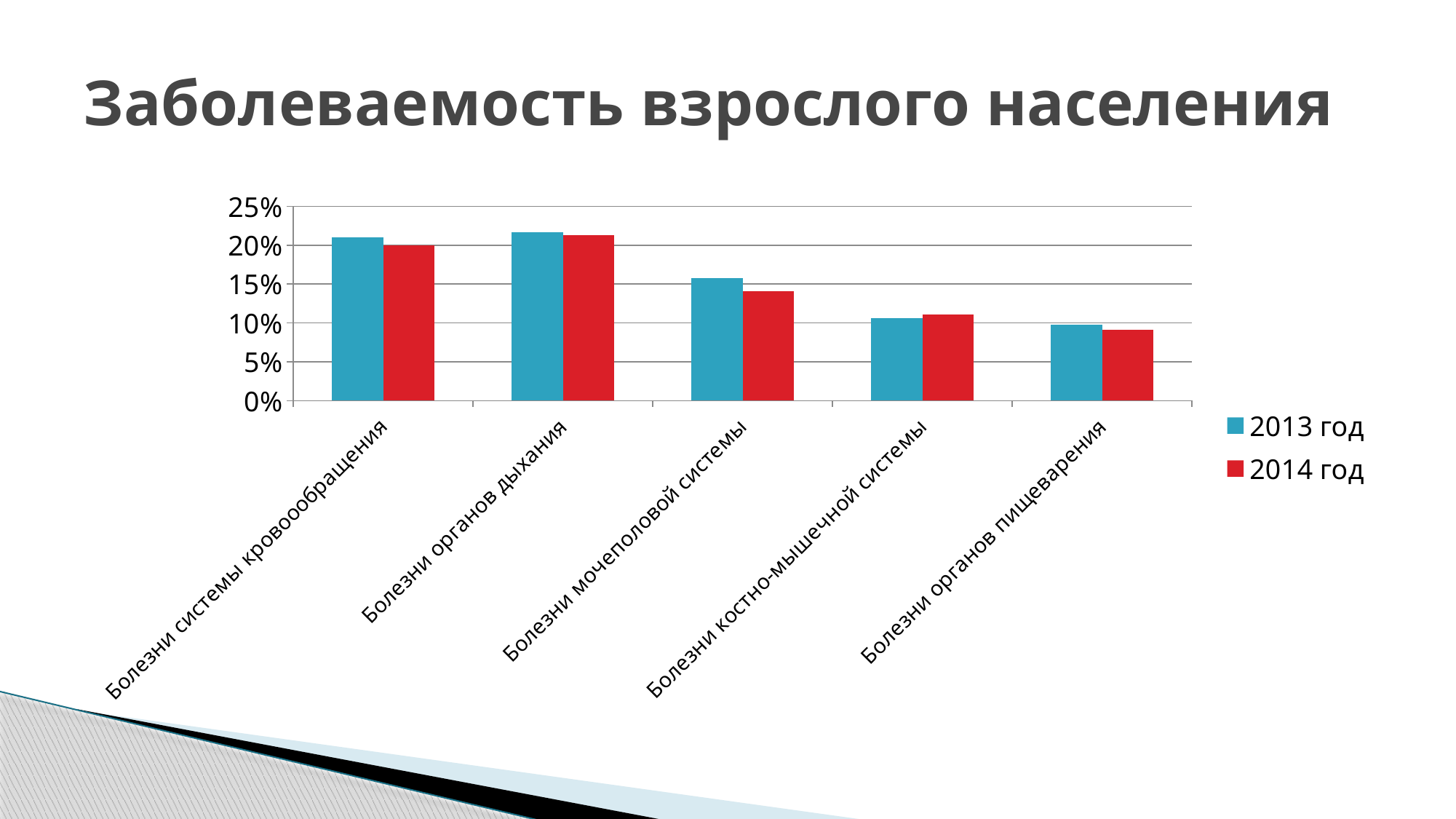
Is the value for Болезни органов дыхания in 2013 год greater or less than 20%? greater What is the title of the chart on the slide? Заболеваемость взрослого населения Is the value for Болезни мочеполовой системы in 2014 год greater or less than 15%? less How many series does the legend list? 2 What kind of chart is shown on the slide? bar chart Which series is shown in red in the legend? 2014 год Which category has the lowest value for 2013 год? Болезни органов пищеварения For Болезни мочеполовой системы, which year has the larger value, 2013 год or 2014 год? 2013 год Which category has the lowest value for 2014 год? Болезни органов пищеварения Which category has the highest value for 2014 год? Болезни органов дыхания Is the value for Болезни органов пищеварения in 2014 год greater or less than 10%? less How many disease categories are shown on the x axis? 5